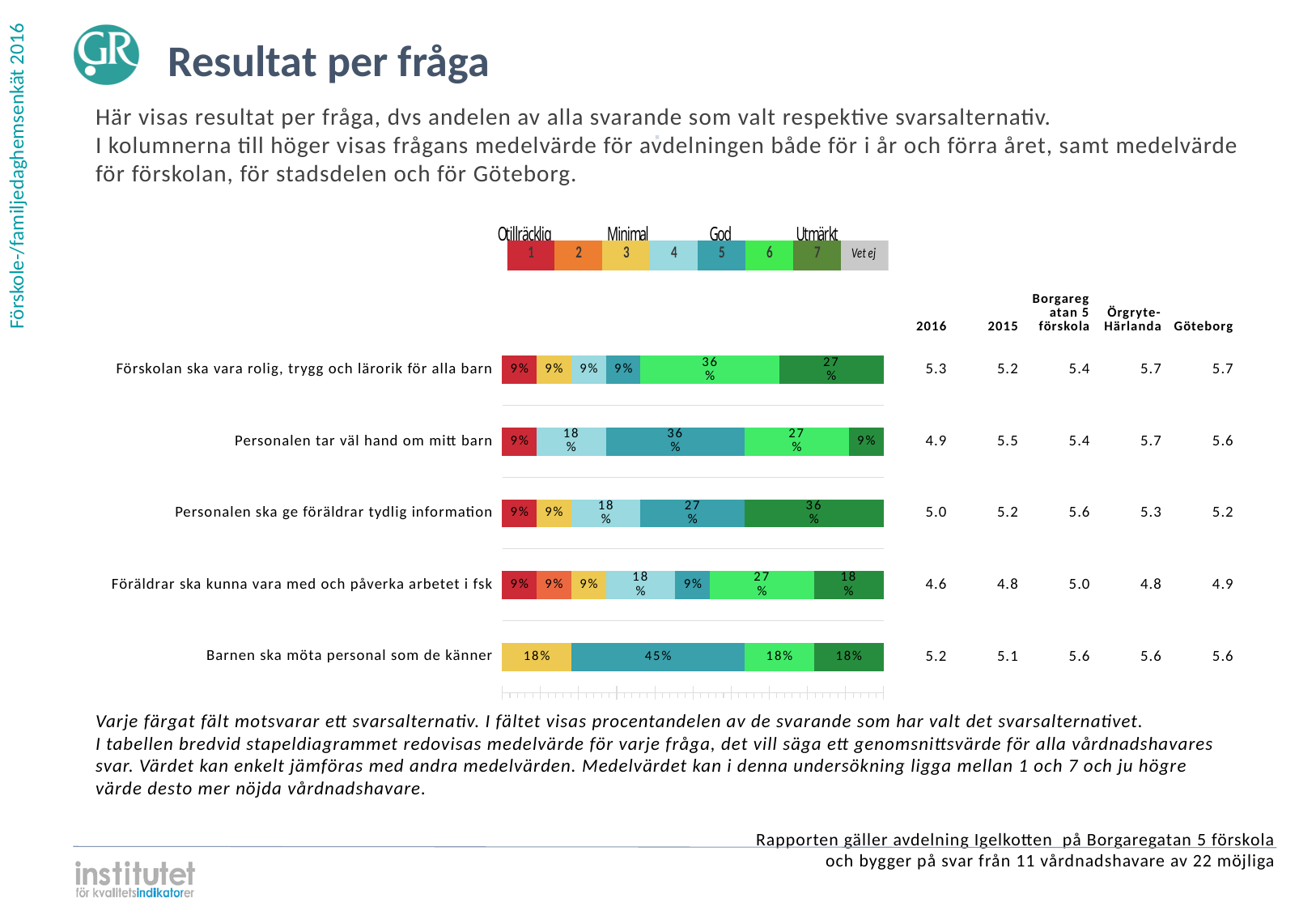
What is the combined share of alternatives 6 and 7 for 'Barnen ska möta personal som de känner'? 36% How many answer alternatives does the legend above the chart list? 8 Which is larger: the alternative 7 (dark green) share for 'Förskolan ska vara rolig, trygg och lärorik för alla barn' or for 'Föräldrar ska kunna vara med och påverka arbetet i fsk'? Förskolan ska vara rolig, trygg och lärorik för alla barn What percentage of respondents chose alternative 6 (bright green) for 'Förskolan ska vara rolig, trygg och lärorik för alla barn'? 36% Which colour represents answer alternative 1 (Otillräcklig) in the legend? Red How many questions (categories) are plotted in the bar chart? 5 What percentage chose alternative 7 (dark green) for 'Personalen ska ge föräldrar tydlig information'? 36% Which question has the largest single segment in its bar? Barnen ska möta personal som de känner What percentage chose alternative 5 (teal) for 'Barnen ska möta personal som de känner'? 45% What is the difference between the alternative 5 (teal) share for 'Barnen ska möta personal som de känner' and the alternative 5 share for 'Personalen tar väl hand om mitt barn'? 9% What percentage chose alternative 7 (dark green) for 'Personalen tar väl hand om mitt barn'? 9% What kind of chart is shown on the slide? Stacked bar chart